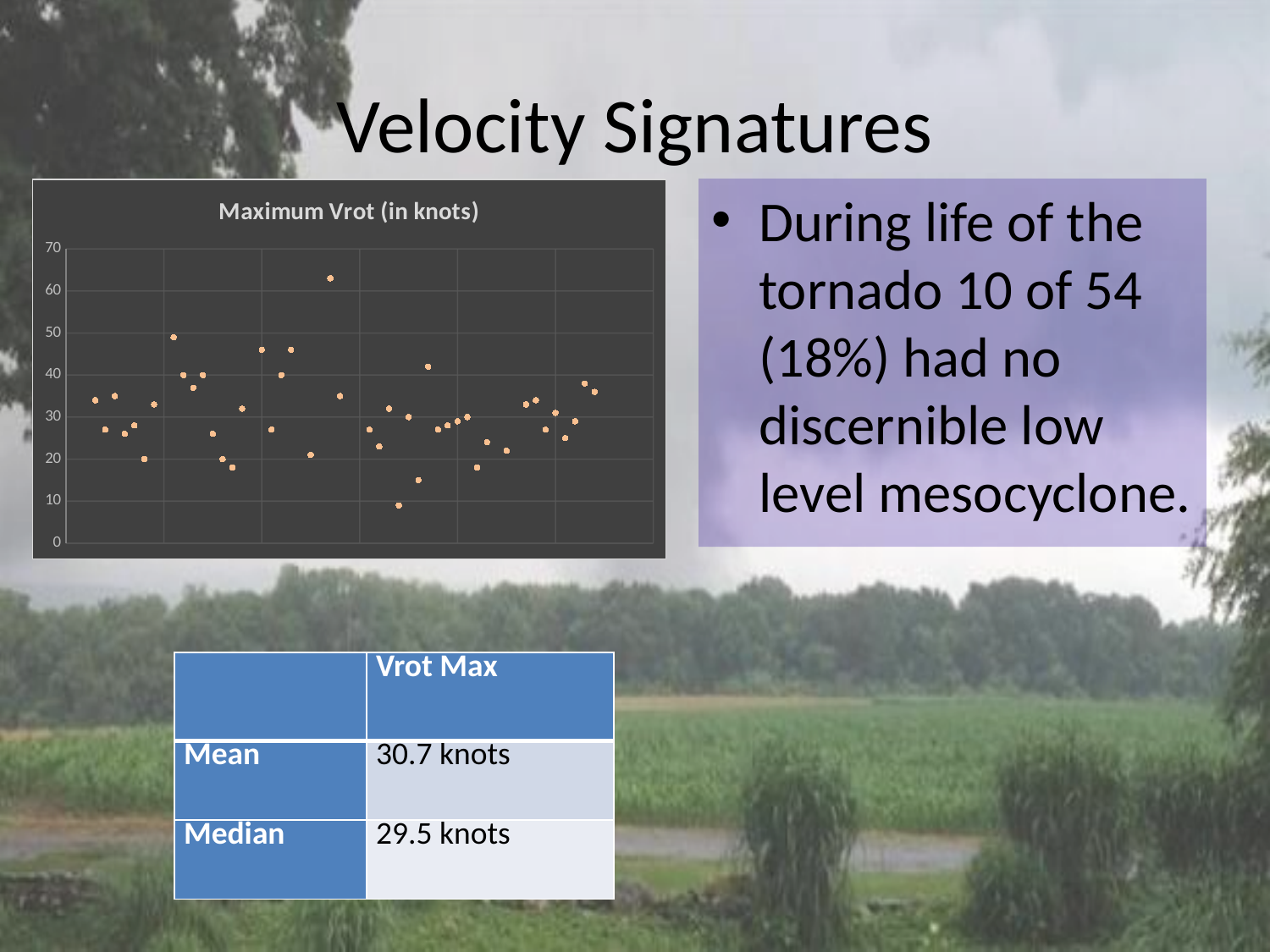
Do any plotted points on the chart exceed 70? No Is the highest plotted point on the chart greater or less than 60? greater What is the highest value shown on the chart's vertical axis? 70 Is the lowest plotted point on the chart greater or less than 20? less What is the title of the chart? Maximum Vrot (in knots) What kind of chart is shown on the slide? scatter chart